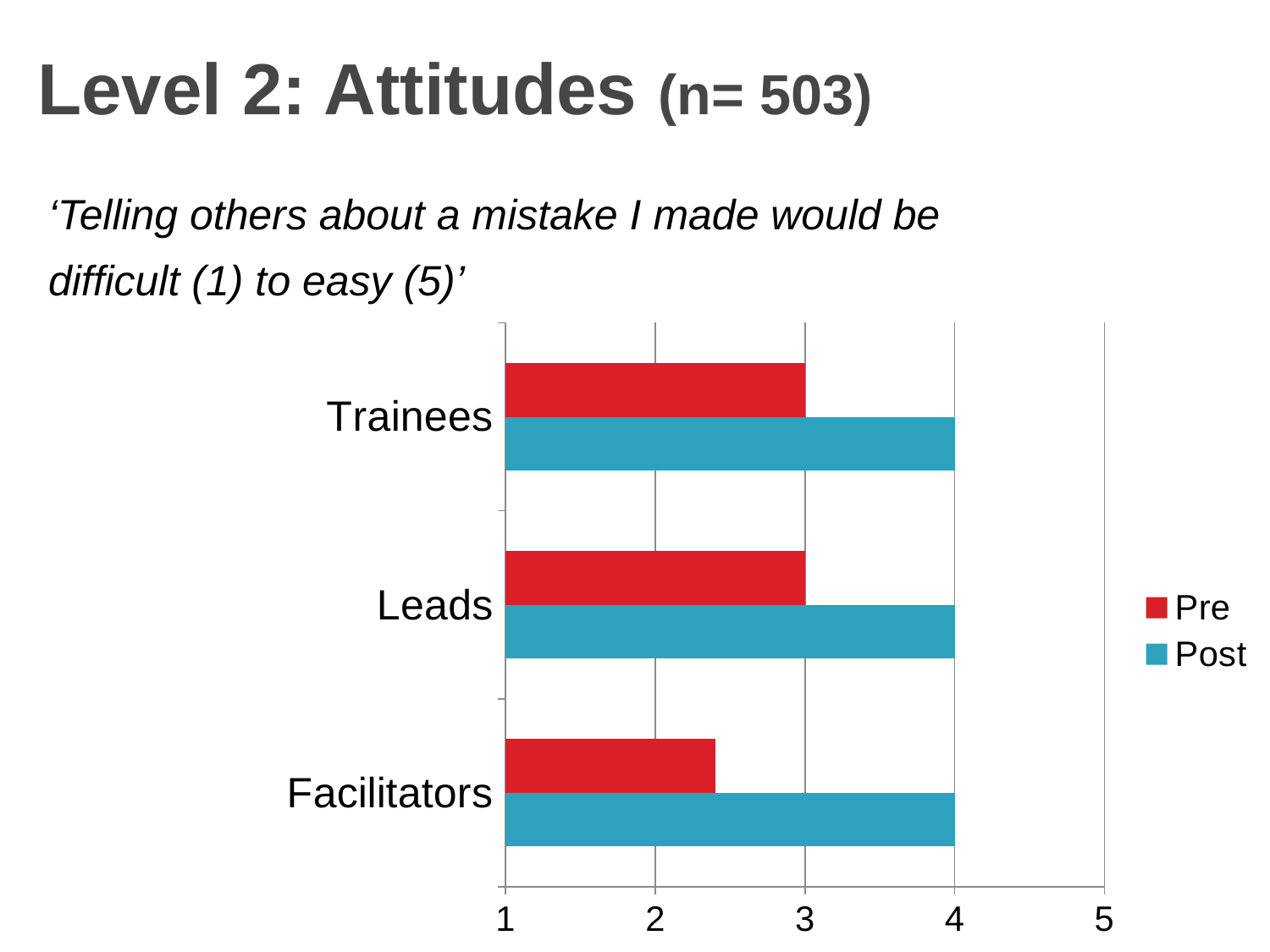
How many categories are shown on the chart? 3 What is the Pre value for Leads? 3 What is the Pre value for Trainees? 3 Is the Pre value for Facilitators greater or less than 3? less What is the Post value for Facilitators? 4 Is the Pre value for Facilitators greater or less than 2? greater For Facilitators, which is larger, the Pre value or the Post value? Post What is the Post value for Trainees? 4 What is the difference between the Post and Pre values for Leads? 1 Which category has the lowest Pre value? Facilitators How many series does the chart's legend list? 2 What kind of chart is shown on the slide? bar chart